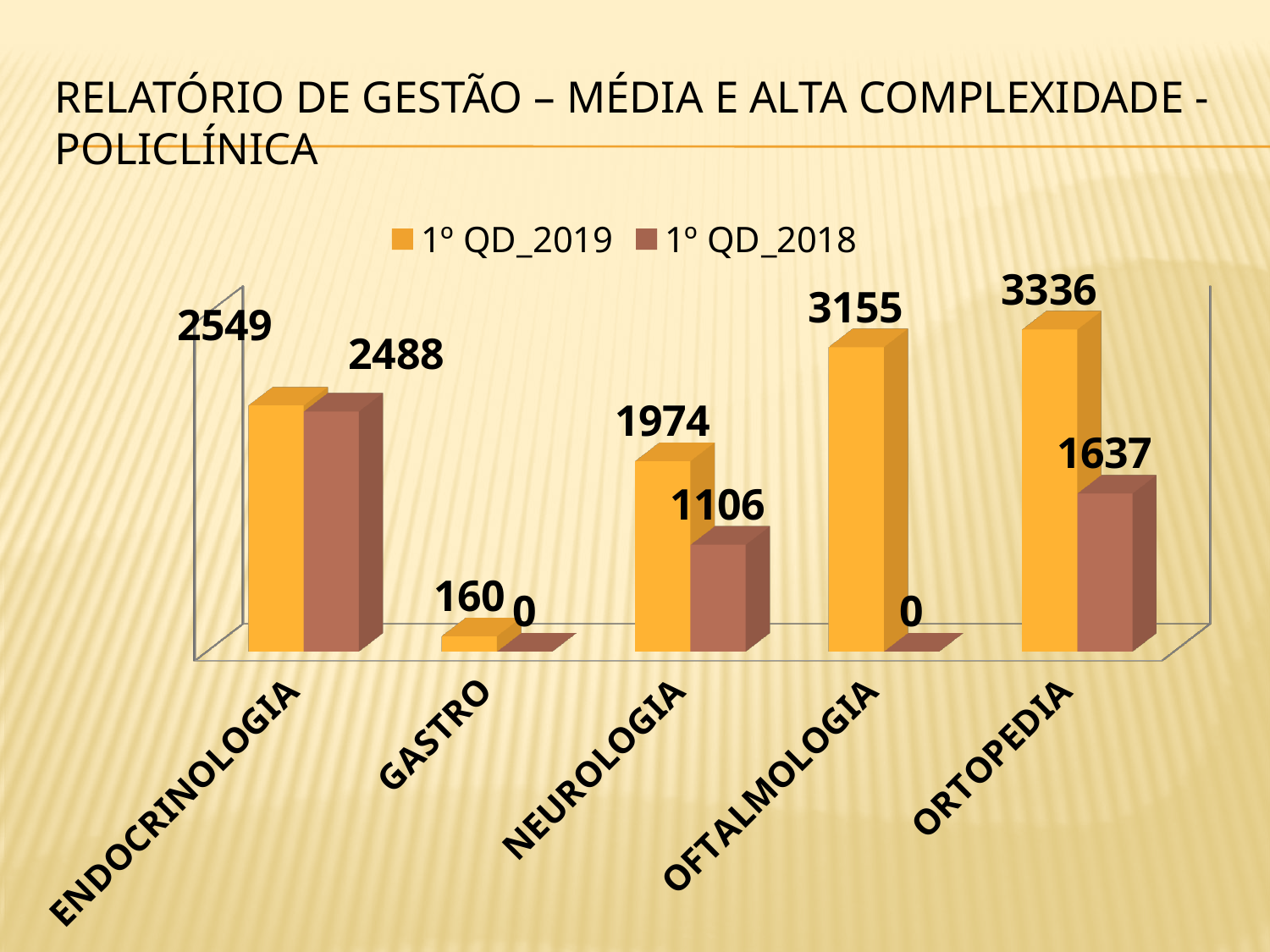
Which category has the highest value in the 1º QD_2019 series? ORTOPEDIA Which is larger for ORTOPEDIA: the 1º QD_2019 value or the 1º QD_2018 value? 1º QD_2019 What is the value for GASTRO in the 1º QD_2019 series? 160 What is the difference between the 1º QD_2019 and 1º QD_2018 values for NEUROLOGIA? 868 What is the value for ORTOPEDIA in the 1º QD_2018 series? 1637 What is the value for ENDOCRINOLOGIA in the 1º QD_2019 series? 2549 How many series does the legend list? 2 Which category has the highest value in the 1º QD_2018 series? ENDOCRINOLOGIA What kind of chart is shown on the slide? Bar chart How many categories are shown on the x axis? 5 Which category has the lowest value in the 1º QD_2019 series? GASTRO What is the value for OFTALMOLOGIA in the 1º QD_2018 series? 0